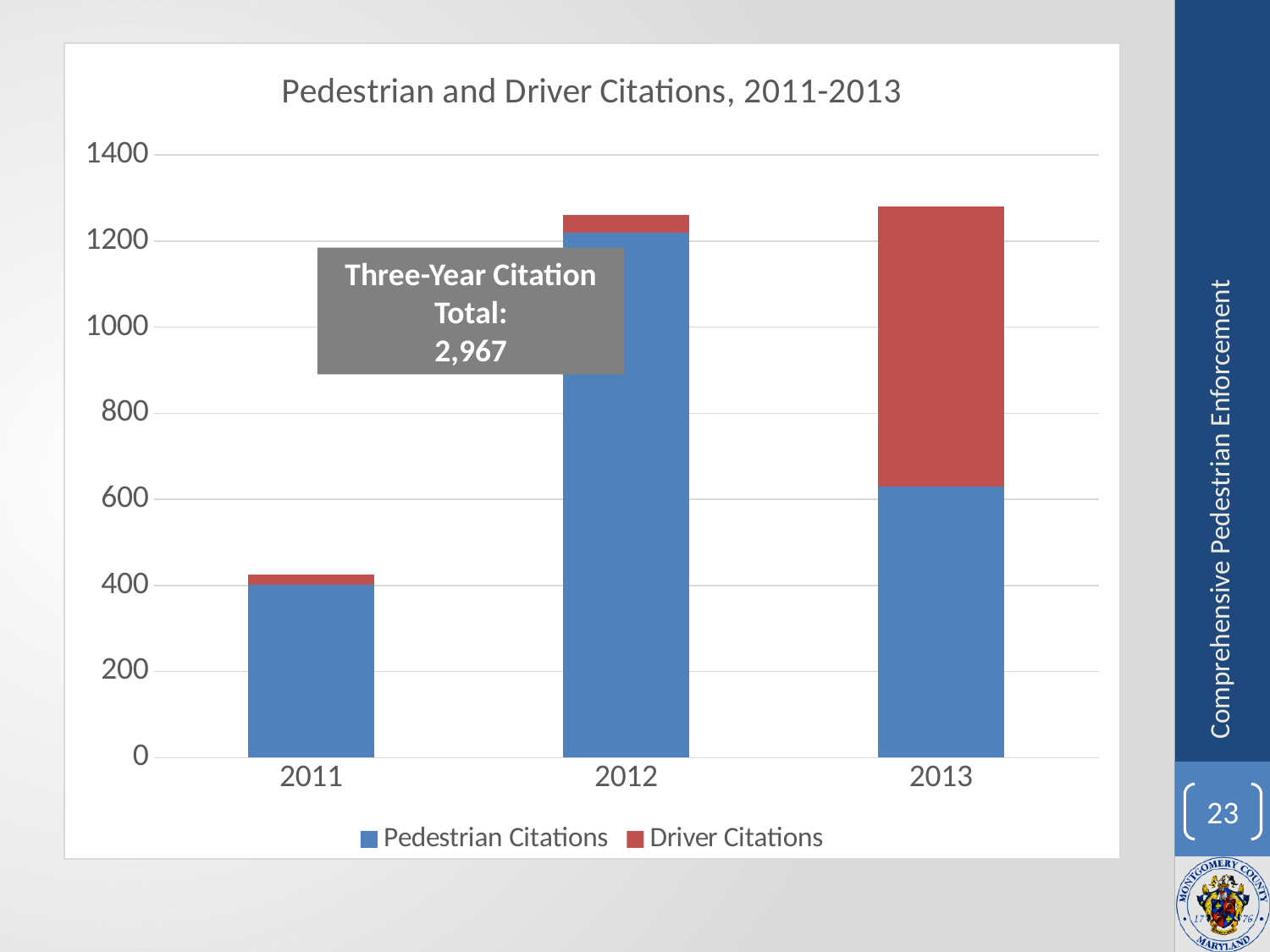
Which year has the lowest total stacked bar? 2011 What kind of chart is shown on the slide? Stacked bar chart Is the value for Pedestrian Citations in 2012 greater or less than 1000? greater How many series does the chart's legend list? 2 Is the total stacked bar for 2013 greater or less than 1200? greater Which year has more Pedestrian Citations, 2012 or 2013? 2012 Do Driver Citations rise or fall from 2011 to 2013? rise What is the title of the chart? Pedestrian and Driver Citations, 2011-2013 Is the value for Pedestrian Citations in 2011 greater or less than 600? less How many years are shown on the x axis of the chart? 3 Which year has more Driver Citations, 2011 or 2013? 2013 What three-year citation total is printed in the box on the chart? 2,967